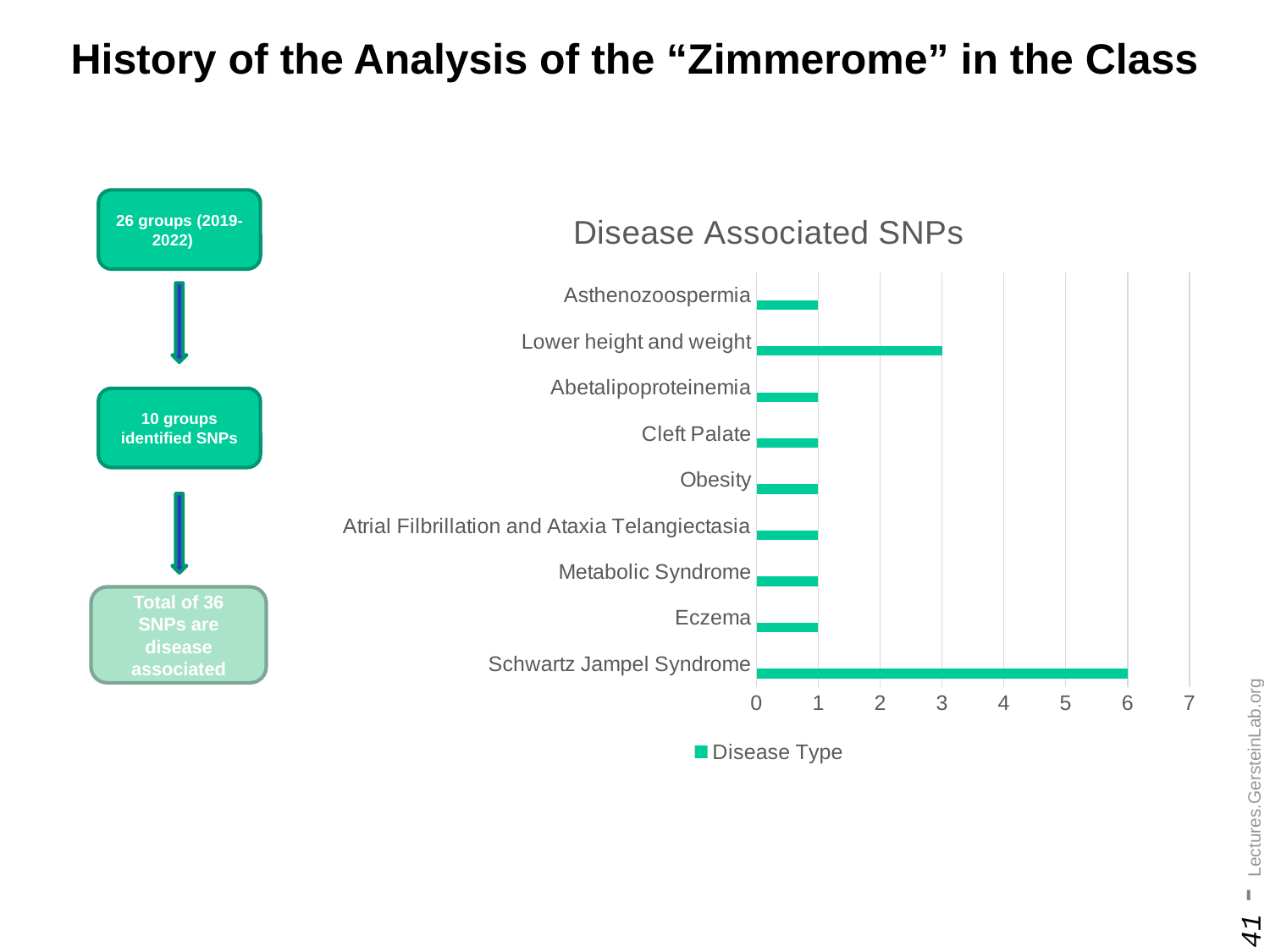
What is the value for Eczema? 1 Is the value for Schwartz Jampel Syndrome greater or less than 5? greater What is the name of the series shown in the chart legend? Disease Type What is the difference between the values for Schwartz Jampel Syndrome and Lower height and weight? 3 What is the value for Lower height and weight? 3 What is the title of the chart? Disease Associated SNPs Which disease has the highest value in the chart? Schwartz Jampel Syndrome What type of chart is shown on the slide? bar chart Which has a larger value, Lower height and weight or Obesity? Lower height and weight How many series does the chart legend list? 1 How many disease categories are plotted in the chart? 9 What is the value for Schwartz Jampel Syndrome? 6